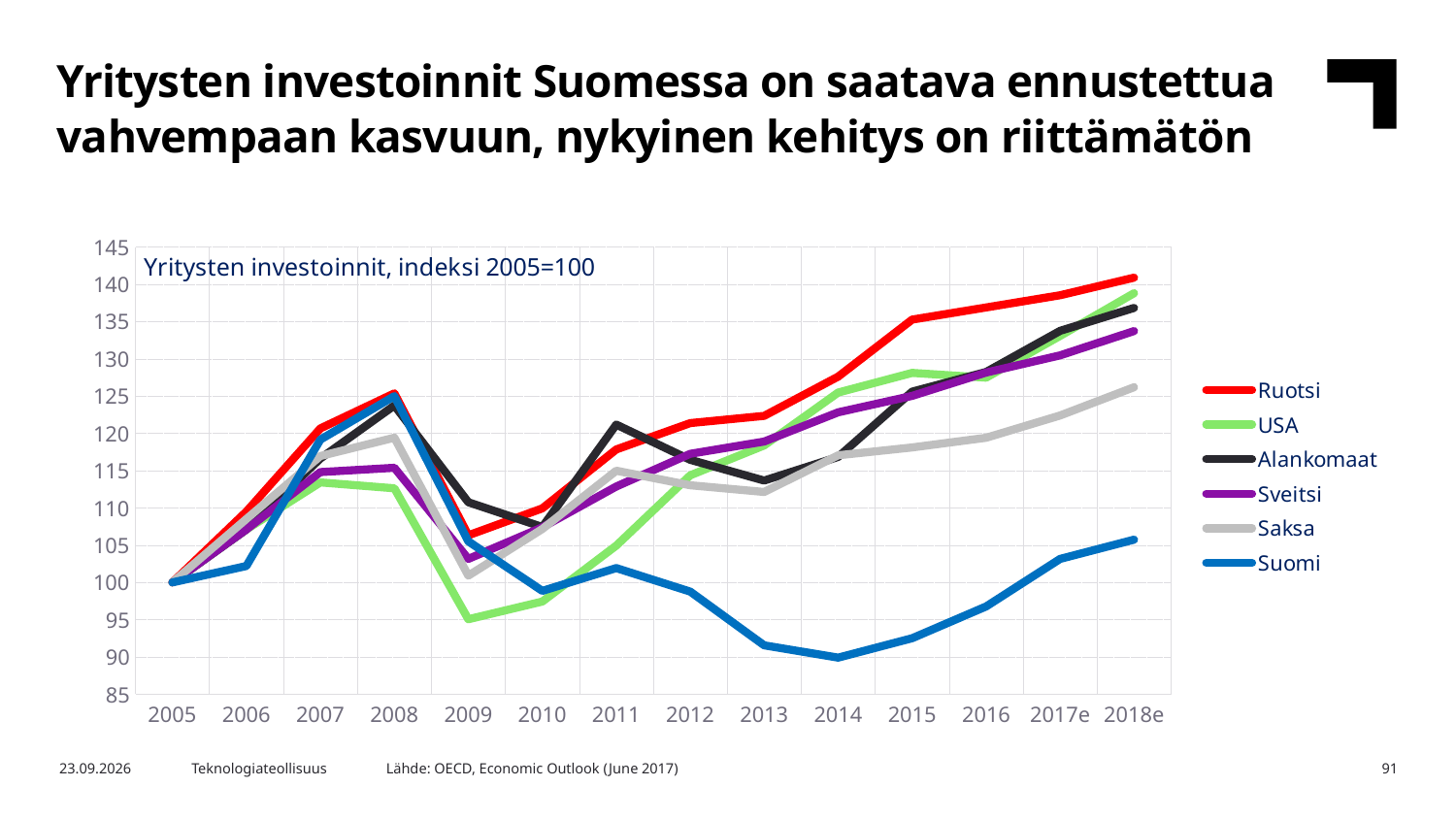
Which country has the highest index value in 2018e? Ruotsi How many years are shown on the x axis? 14 Is the value for Suomi in 2014 greater or less than 95? less Which country has the lowest index value in 2018e? Suomi Does the Suomi line rise or fall from 2014 to 2018e? rise What is the index value for Ruotsi in 2005? 100 How many series does the legend list? 6 Is the value for Ruotsi in 2015 greater or less than 130? greater What kind of chart is shown on the slide? line chart What is the title shown inside the chart area? Yritysten investoinnit, indeksi 2005=100 Which country has the lowest index value in 2009? USA Which is larger in 2011, the value for Alankomaat or the value for Sveitsi? Alankomaat